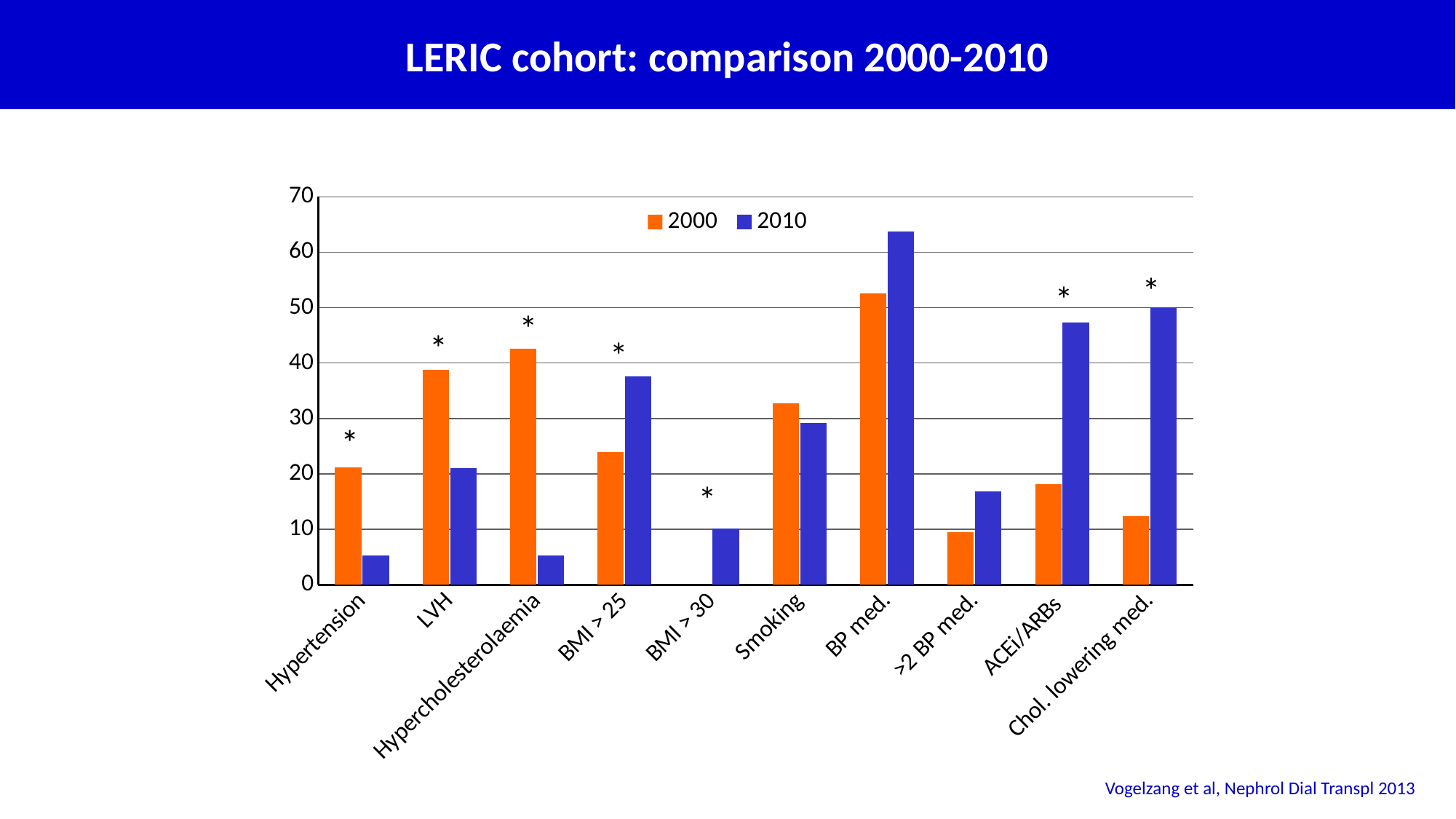
For Hypercholesterolaemia, which series has the larger value, 2000 or 2010? 2000 Is the 2010 value for BMI > 25 greater or less than 40? less Which category has the highest value for the 2000 series? BP med. Which category has the highest value for the 2010 series? BP med. How many series does the legend list? 2 What is the title of the slide containing the chart? LERIC cohort: comparison 2000-2010 Is the 2000 value for Hypercholesterolaemia greater or less than 40? greater For ACEi/ARBs, which series has the larger value, 2000 or 2010? 2010 How many categories are shown on the x axis? 10 Is the 2010 value for BP med. greater or less than 60? greater What kind of chart is shown on the slide? bar chart